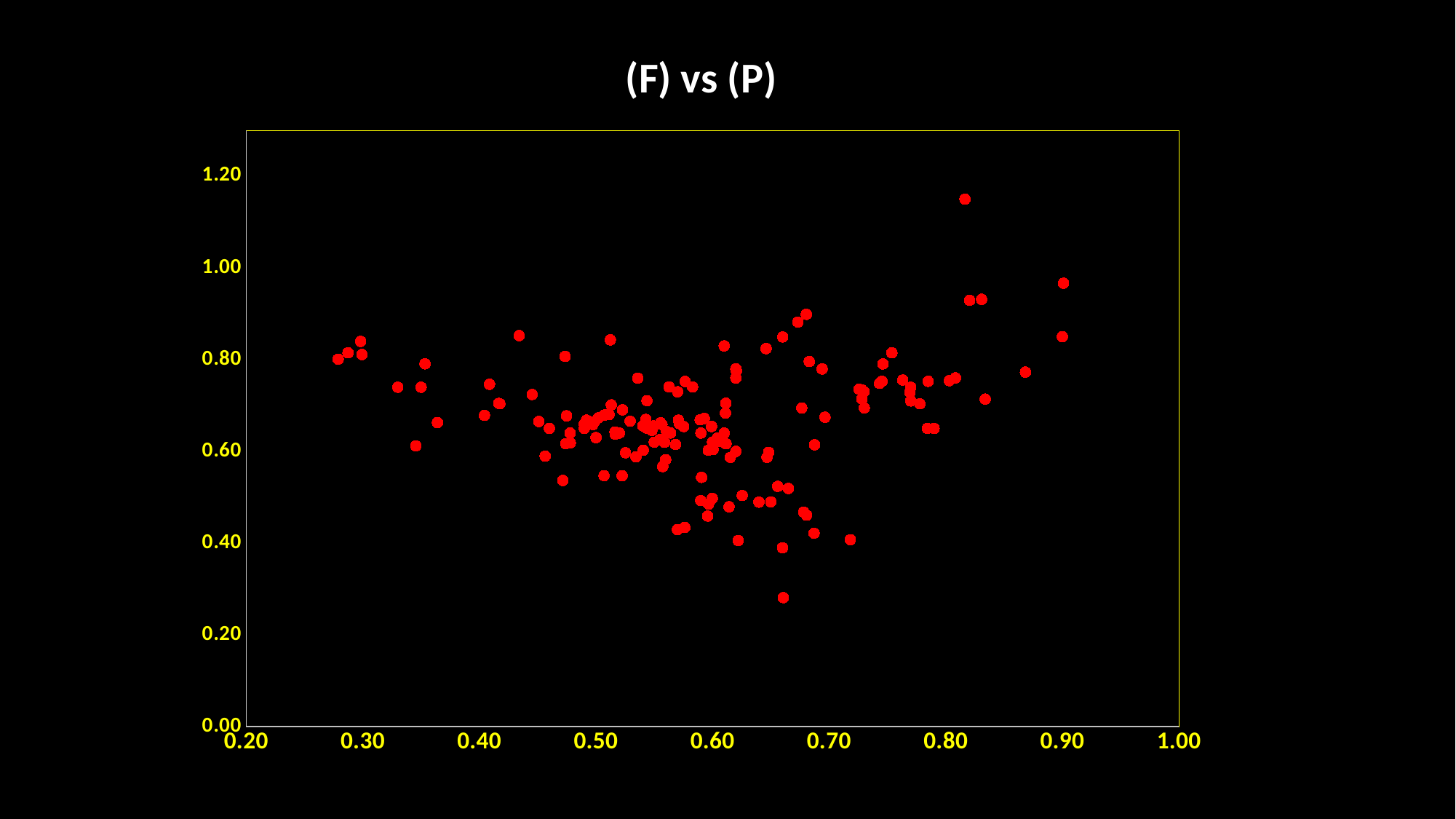
Is the y value of the rightmost point on the chart greater or less than 0.80? greater Is the y value of the leftmost point on the chart greater or less than 0.60? greater Is the x value of the lowest point on the chart greater or less than 0.60? greater How many data series are plotted on the chart? 1 What colour are the plotted points? red What is the title of the chart? (F) vs (P) What kind of chart is shown on the slide? scatter plot